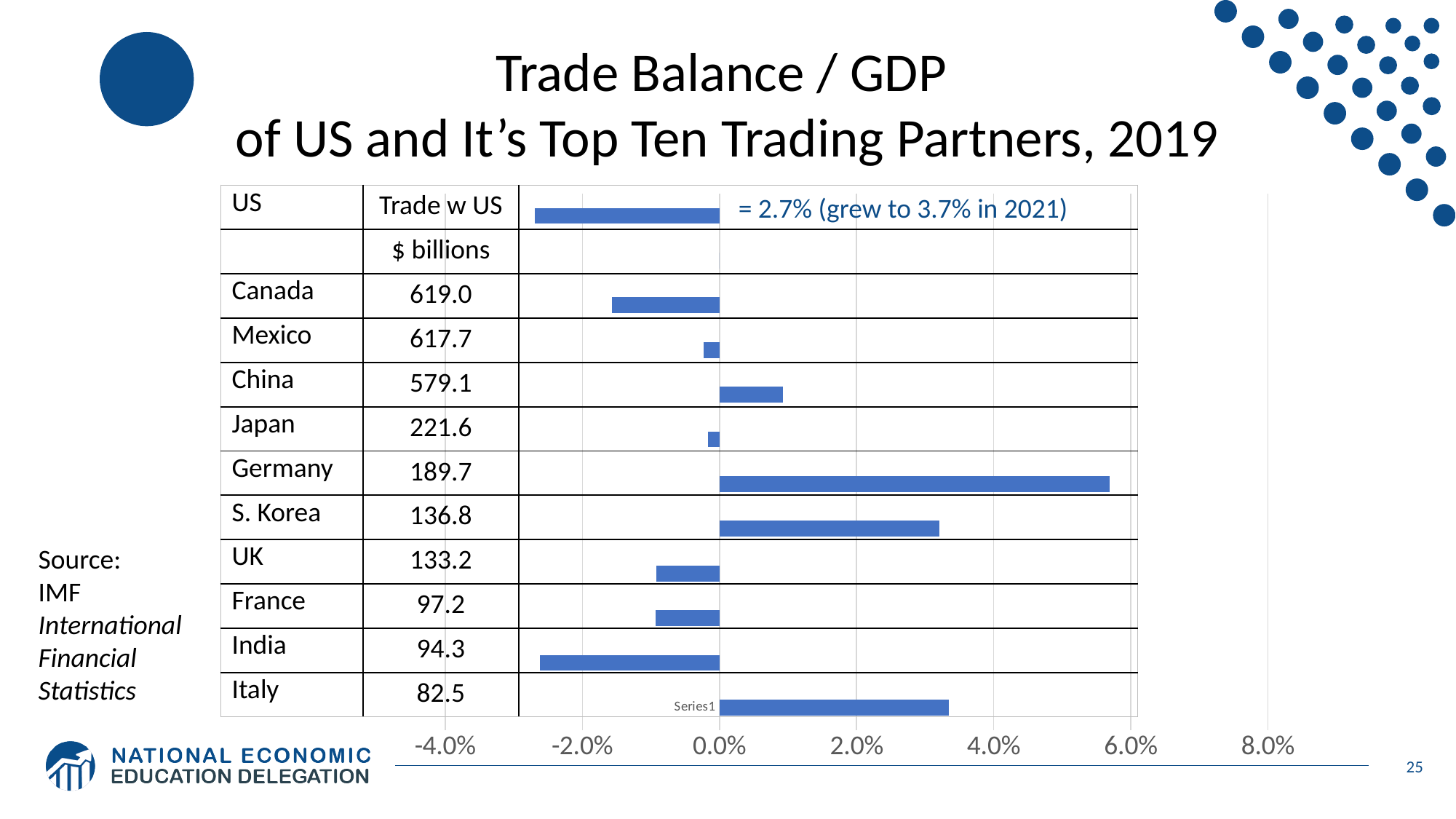
Is the value for Italy greater or less than 2.0%? greater Which is larger, the value for Germany or the value for S. Korea? Germany Is the value for China greater or less than 0.0%? greater Which country has the highest trade balance / GDP bar on the chart? Germany What kind of chart is shown on the slide? bar chart Which is larger, the value for China or the value for Canada? China Is the value for Canada greater or less than 0.0%? less What is the highest value shown on the chart's horizontal axis? 8.0% How many bars (countries including the US) are plotted on the chart? 11